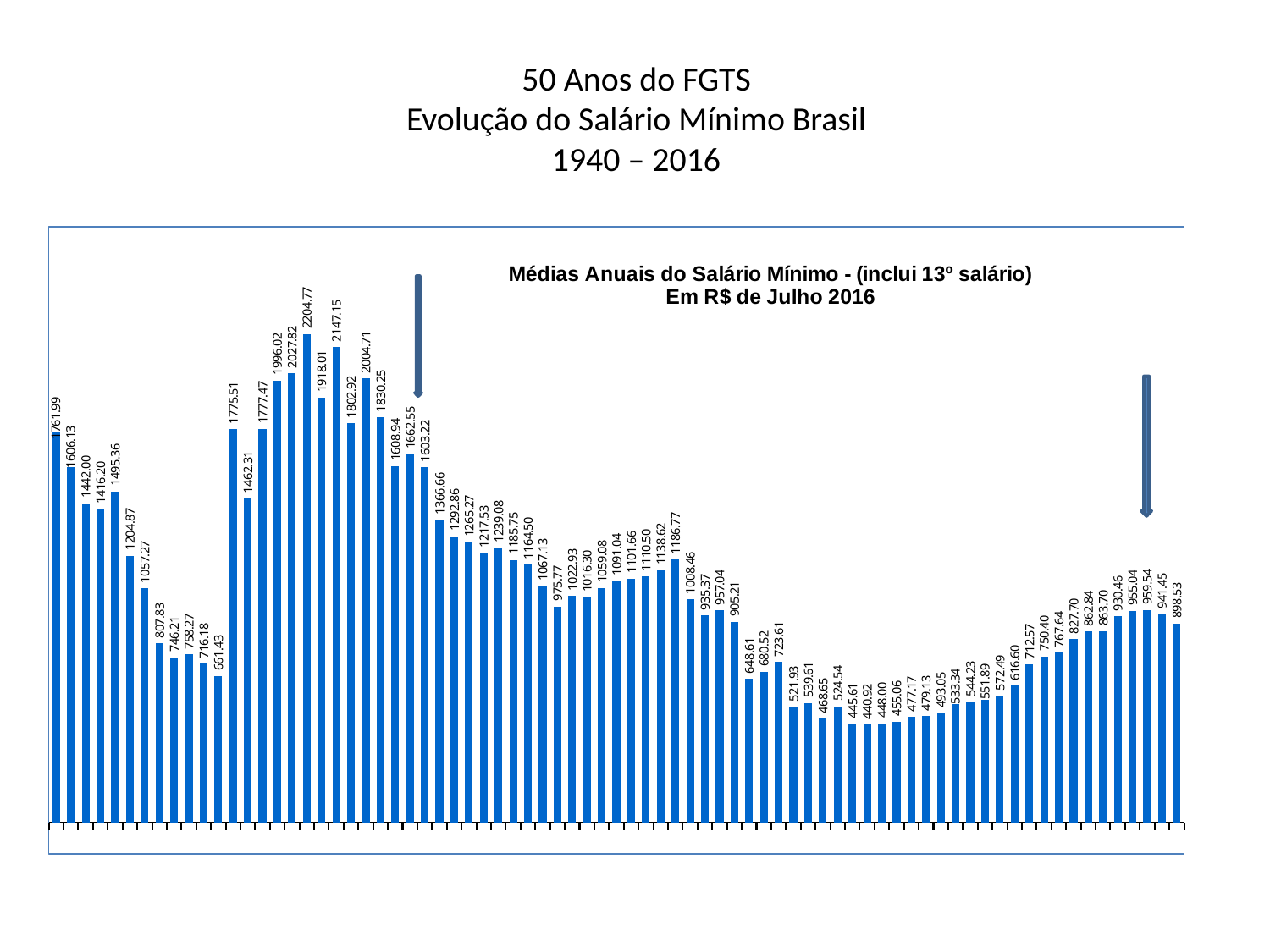
What is the title printed inside the chart area? Médias Anuais do Salário Mínimo - (inclui 13º salário) Em R$ de Julho 2016 What is the value labelled on the first (leftmost) bar of the chart? 1761.99 What is the value labelled on the last (rightmost) bar of the chart? 898.53 Which is larger, the value of the leftmost bar or the value of the rightmost bar? the leftmost bar Do the values generally rise or fall across the first twelve bars on the left of the chart? fall What is the highest value labelled on any bar in the chart? 2204.77 What kind of chart is shown on the slide? bar chart What colour are the bars in the chart? blue What is the difference between the leftmost bar (1761.99) and the rightmost bar (898.53)? 863.46 What is the difference between the highest bar (2204.77) and the lowest bar (440.92)? 1763.85 How many bars are plotted in the chart? 77 What is the lowest value labelled on any bar in the chart? 440.92